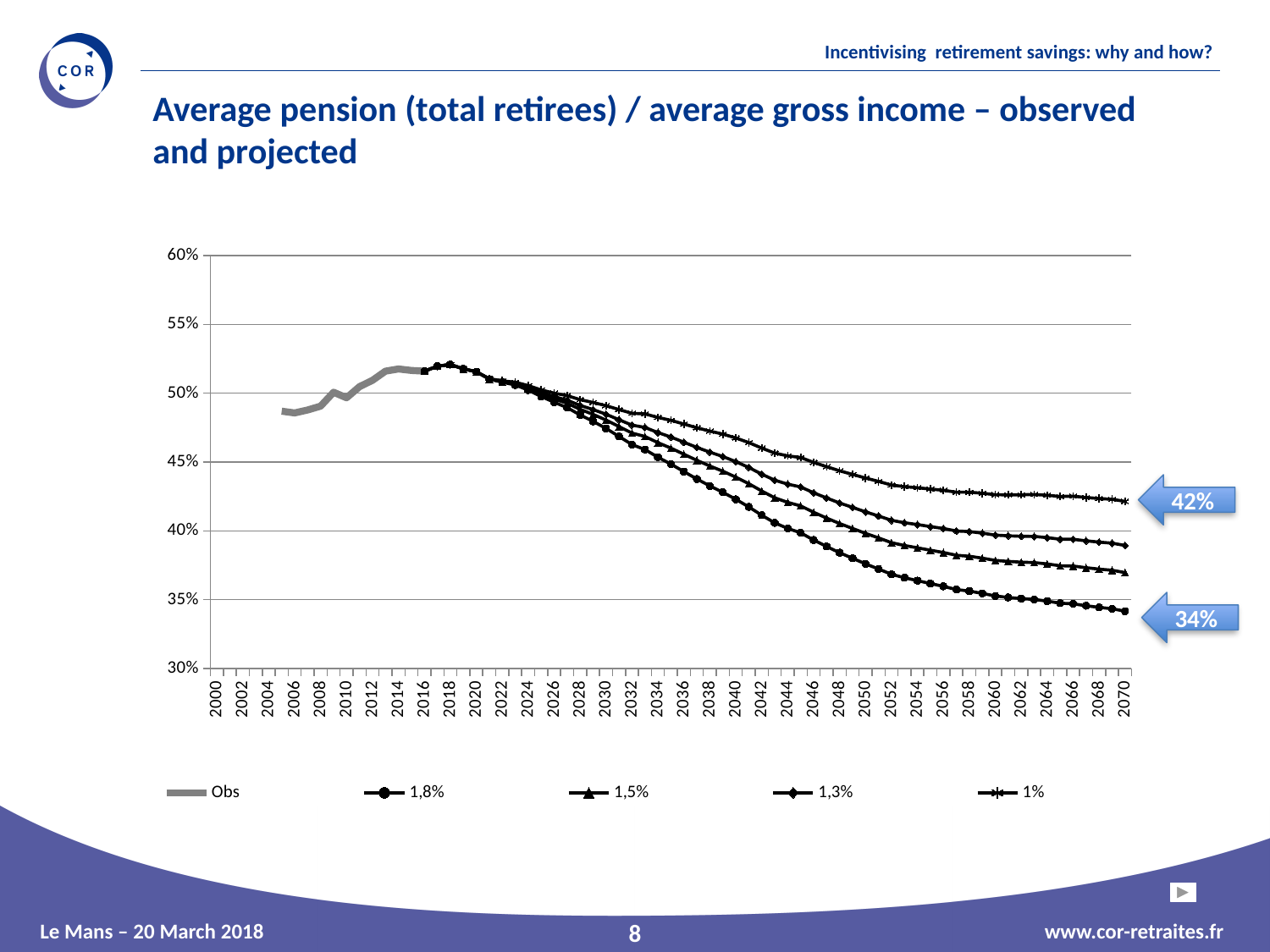
Which legend entry is drawn as a thick grey line? Obs In 2070, which is larger: the value of the 1,3% series or the value of the 1,8% series? 1,3% Which series is lowest in 2070? 1,8% What value is annotated for the 1% series at the end of the projection in 2070? 42% How many series does the chart legend list? 5 Is the value for the 1,8% series in 2040 greater or less than 45%? less What value is annotated for the 1,8% series at the end of the projection in 2070? 34% Which series is highest in 2070? 1% Is the value for the 1,5% series in 2070 greater or less than 40%? less What kind of chart is shown on the slide? line chart What is the difference between the annotated 2070 values of the 1% series and the 1,8% series? 8 percentage points Do the projected series rise or fall between 2020 and 2070? fall